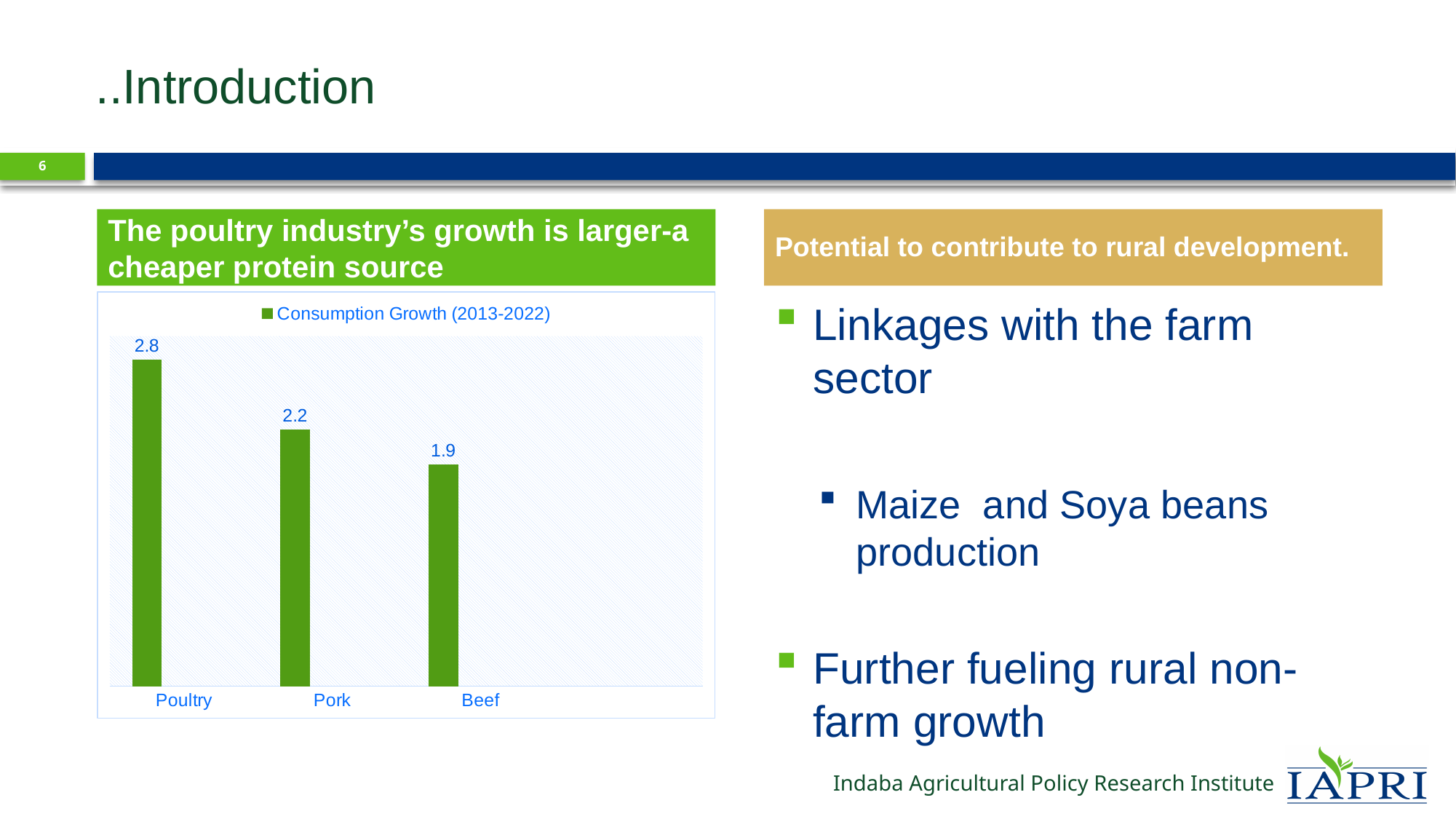
How many categories are shown in the chart? 3 Which category has the highest consumption growth? Poultry What is the legend entry of the chart? Consumption Growth (2013-2022) What is the consumption growth value for Poultry? 2.8 What is the consumption growth value for Beef? 1.9 What is the consumption growth value for Pork? 2.2 Which has a larger consumption growth value, Pork or Beef? Pork What is the difference between the consumption growth values for Poultry and Beef? 0.9 What is the difference between the consumption growth values for Pork and Beef? 0.3 Which category has the lowest consumption growth? Beef What kind of chart is shown on the slide? Bar chart How many series does the legend list? 1